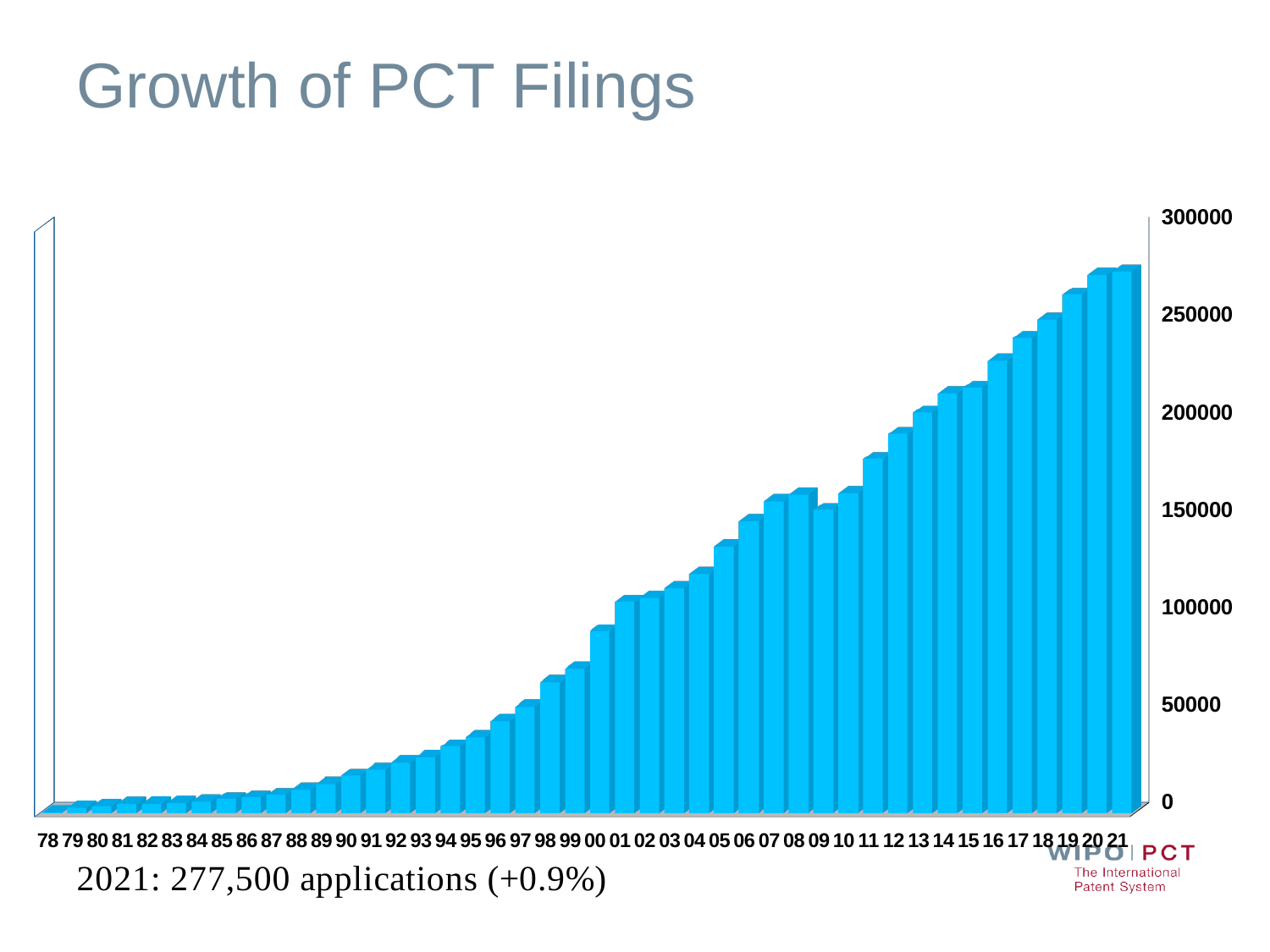
What kind of chart is shown on the slide? bar chart According to the text on the slide, how many PCT applications were filed in 2021? 277,500 Which year has the highest number of PCT filings? 21 Which year has more PCT filings, 08 or 09? 08 How many years (bars) are plotted on the chart? 44 Which year has the lowest number of PCT filings? 78 Is the value for 05 greater or less than 150000? less What is the title of the chart? Growth of PCT Filings Do PCT filings generally rise or fall from 78 to 21? rise Is the value for 21 greater or less than 300000? less Which year has more PCT filings, 09 or 10? 10 Is the value for 19 greater or less than 250000? greater